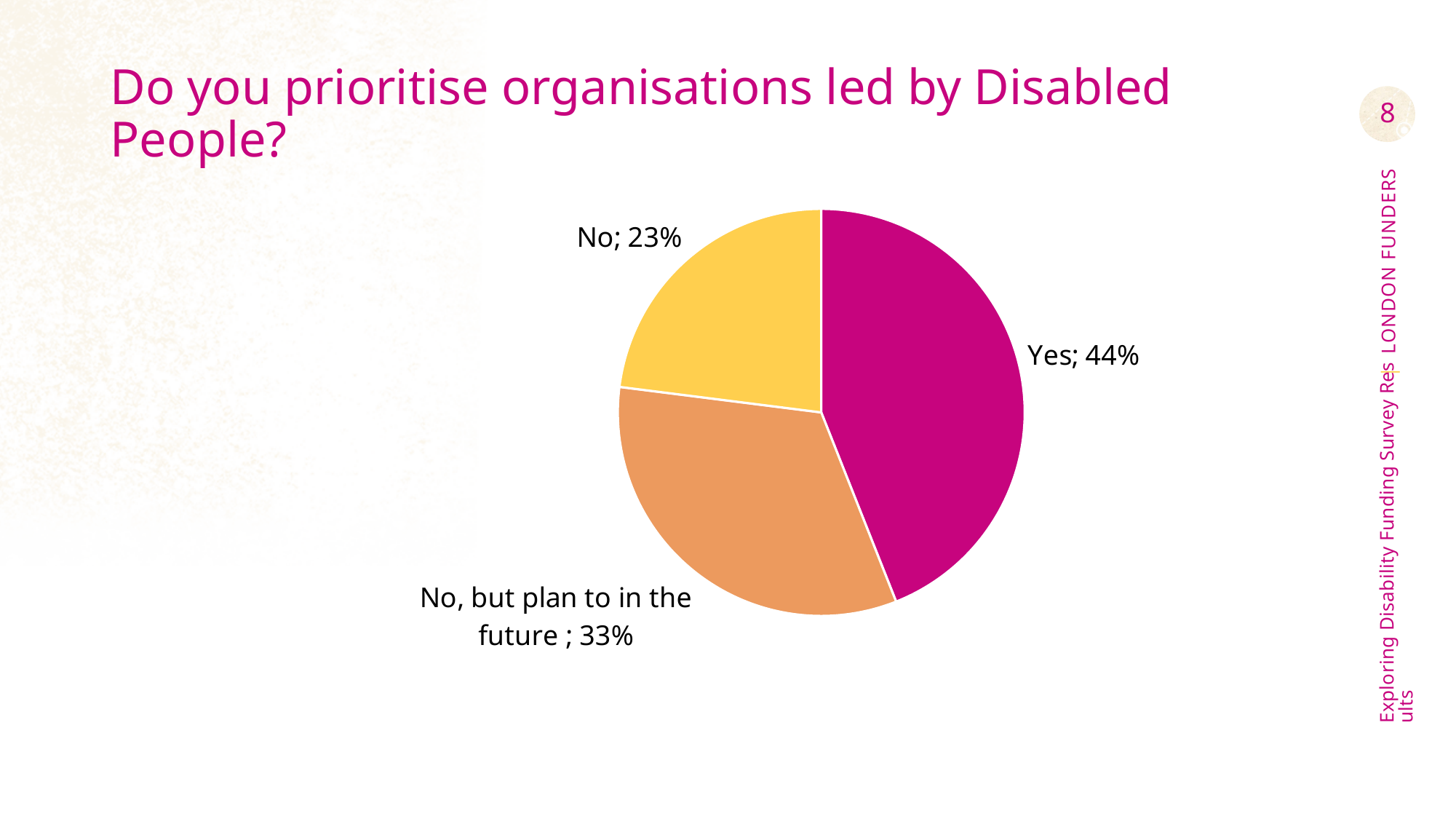
How many slices does the pie chart have? 3 What share of respondents answered "No, but plan to in the future"? 33% What colour is the "Yes" slice? magenta What kind of chart is shown on the slide? pie chart What share of respondents answered "No"? 23% Which response has the smallest slice of the pie? No Which is larger: the share for "No, but plan to in the future" or the share for "No"? No, but plan to in the future What share of respondents answered "Yes"? 44% What is the title of the slide containing the chart? Do you prioritise organisations led by Disabled People? Which response has the largest slice of the pie? Yes What is the difference in percentage points between "Yes" and "No, but plan to in the future"? 11 What is the difference in percentage points between "Yes" and "No"? 21